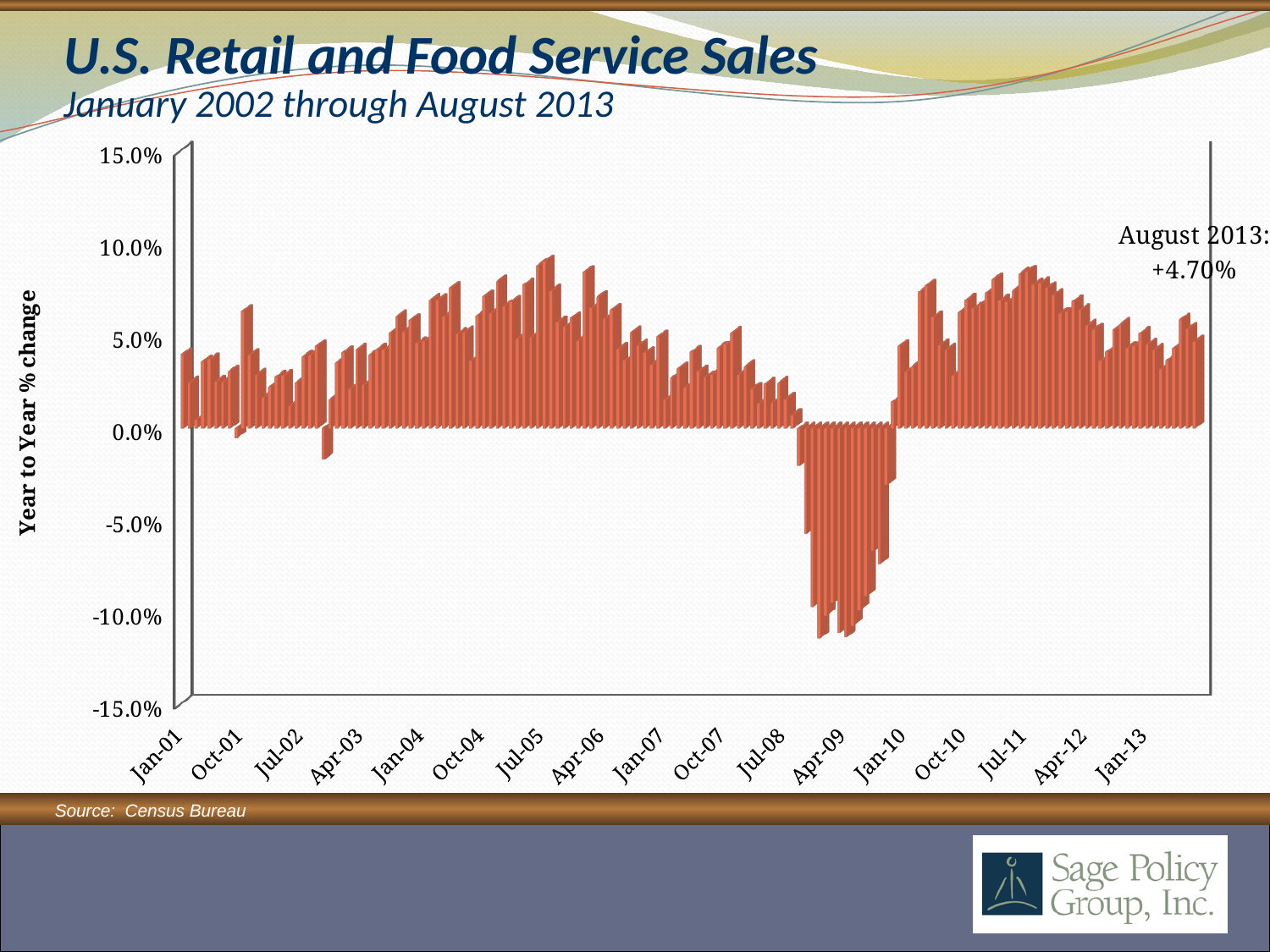
Around which labeled x-axis period do the lowest values on the chart occur? Apr-09 How many labels are shown on the x axis? 17 Do the values rise or fall from Jul-08 to Apr-09? fall What is the year-to-year % change shown for August 2013? +4.70% Is the value around Jul-05 greater or less than 5.0%? greater Is the value around Jan-13 greater or less than 0.0%? greater Which is larger, the value around Jul-05 or the value around Apr-09? Jul-05 Is the value around Apr-09 greater or less than -5.0%? less What is the label on the y axis? Year to Year % change What kind of chart is used to show U.S. Retail and Food Service Sales? bar chart What source is cited for the chart data? Census Bureau Do the values rise or fall from Jan-10 to Jul-11? rise